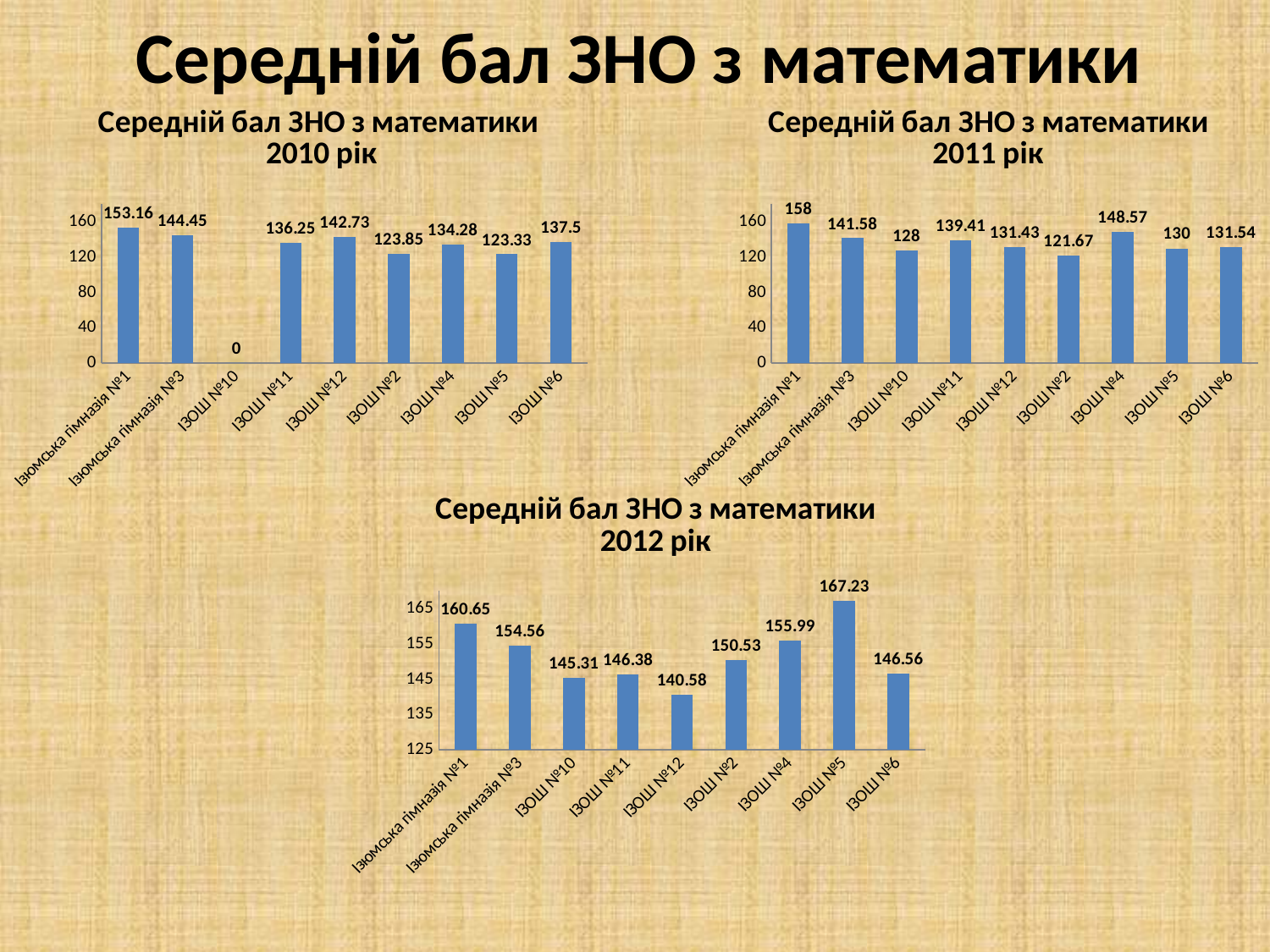
In the 2012 chart, which school has the highest value? ІЗОШ №5 In the 2011 chart, what is the difference between the values for Ізюмська гімназія №1 and ІЗОШ №10? 30 In the 2012 chart, what is the difference between the values for ІЗОШ №5 and ІЗОШ №12? 26.65 In the 2010 chart, which is larger: the value for ІЗОШ №12 or the value for ІЗОШ №11? ІЗОШ №12 In the 2010 chart, which school has the highest value? Ізюмська гімназія №1 How many schools (categories) are shown in the 2012 chart? 9 In the 2011 chart (Середній бал ЗНО з математики 2011 рік), what is the value for ІЗОШ №4? 148.57 In the 2010 chart (Середній бал ЗНО з математики 2010 рік), what is the value for Ізюмська гімназія №1? 153.16 In the 2012 chart (Середній бал ЗНО з математики 2012 рік), what is the value for ІЗОШ №12? 140.58 What is the title of the chart at the bottom of the slide? Середній бал ЗНО з математики 2012 рік In the 2011 chart, which school has the lowest value? ІЗОШ №2 What kind of chart is the 2011 chart? bar chart